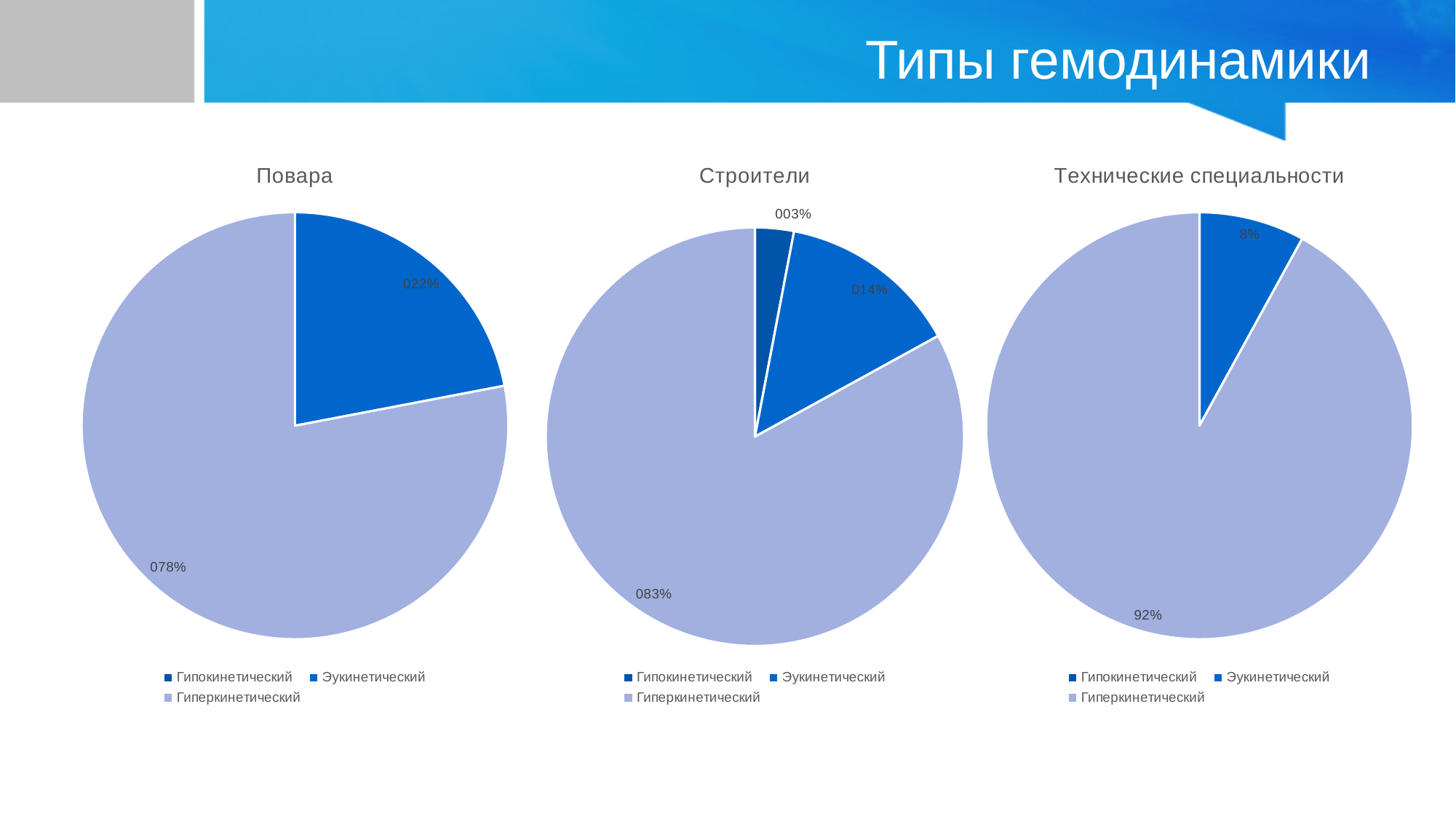
In the "Технические специальности" pie chart, which category has the largest slice? Гиперкинетический In the "Технические специальности" pie chart, what is the value shown for the Эукинетический slice? 8% In the "Строители" pie chart, what is the difference between the Гиперкинетический and Эукинетический values? 69% In the "Строители" pie chart, which category has the smallest slice? Гипокинетический How many entries does the legend of the "Строители" chart list? 3 What type of chart is used for "Повара"? Pie chart In the "Строители" pie chart, what is the value shown for the Гипокинетический slice? 003% In the "Повара" pie chart, what is the value shown for the Эукинетический slice? 022% In the "Строители" pie chart, what is the value shown for the Эукинетический slice? 014% Which is larger: the Эукинетический share in the "Повара" chart or the Эукинетический share in the "Технические специальности" chart? Повара In the "Строители" pie chart, what is the value shown for the Гиперкинетический slice? 083% In the "Повара" pie chart, what is the value shown for the Гиперкинетический slice? 078%